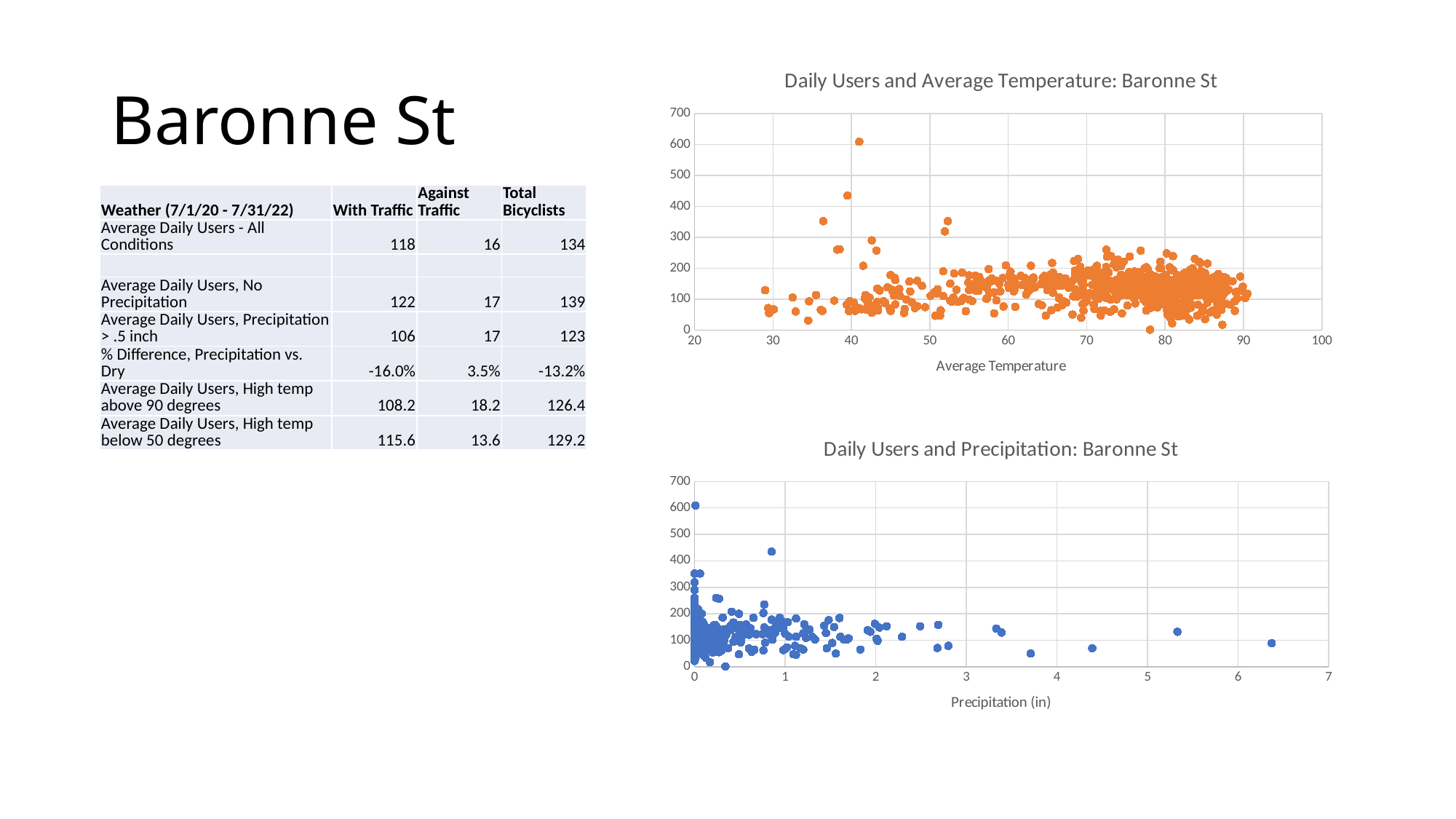
What kind of chart is the 'Daily Users and Average Temperature: Baronne St' chart? scatter chart What is the x-axis label of the 'Daily Users and Precipitation: Baronne St' chart? Precipitation (in) What colour are the points in the 'Daily Users and Average Temperature: Baronne St' chart? orange In the 'Daily Users and Precipitation: Baronne St' chart, is the rightmost point (near 6.4 inches of precipitation) greater or less than 200? less In the 'Daily Users and Average Temperature: Baronne St' chart, is the highest plotted point greater or less than 500? greater What kind of chart is the 'Daily Users and Precipitation: Baronne St' chart? scatter chart In the 'Daily Users and Precipitation: Baronne St' chart, is the highest plotted point greater or less than 500? greater